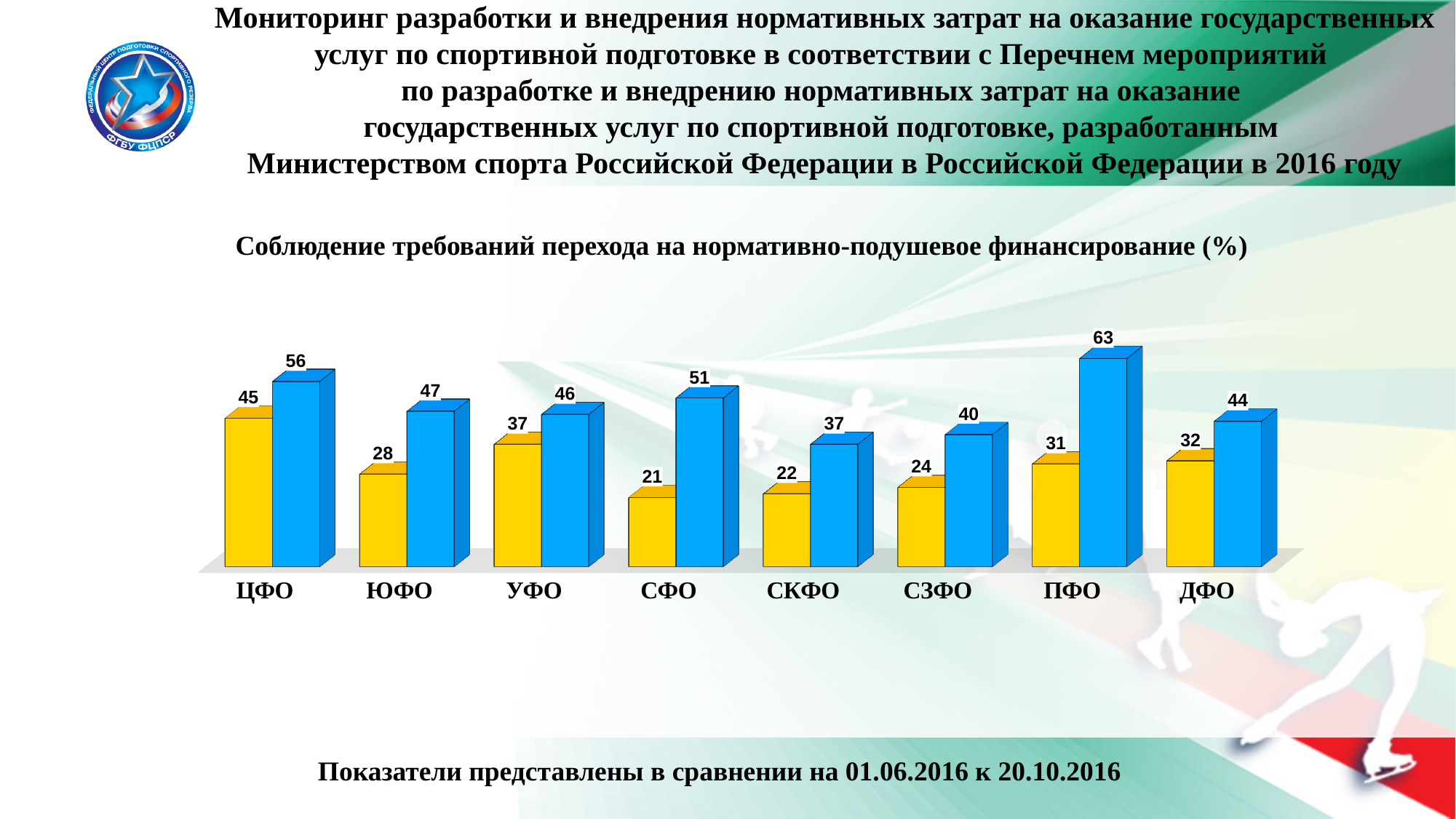
What is the value of the yellow bar for ДФО? 32 What is the difference between the blue and yellow bars for ЦФО? 11 Which category has the highest yellow bar? ЦФО What is the value of the yellow bar for ЦФО? 45 Which category has the highest blue bar? ПФО Which is larger: the blue bar for ЮФО or the blue bar for УФО? ЮФО How many categories are shown on the x axis? 8 Which category has the lowest yellow bar? СФО What is the difference between the blue and yellow bars for ПФО? 32 What is the value of the blue bar for ПФО? 63 What kind of chart is shown on the slide? Bar chart What is the value of the blue bar for СФО? 51